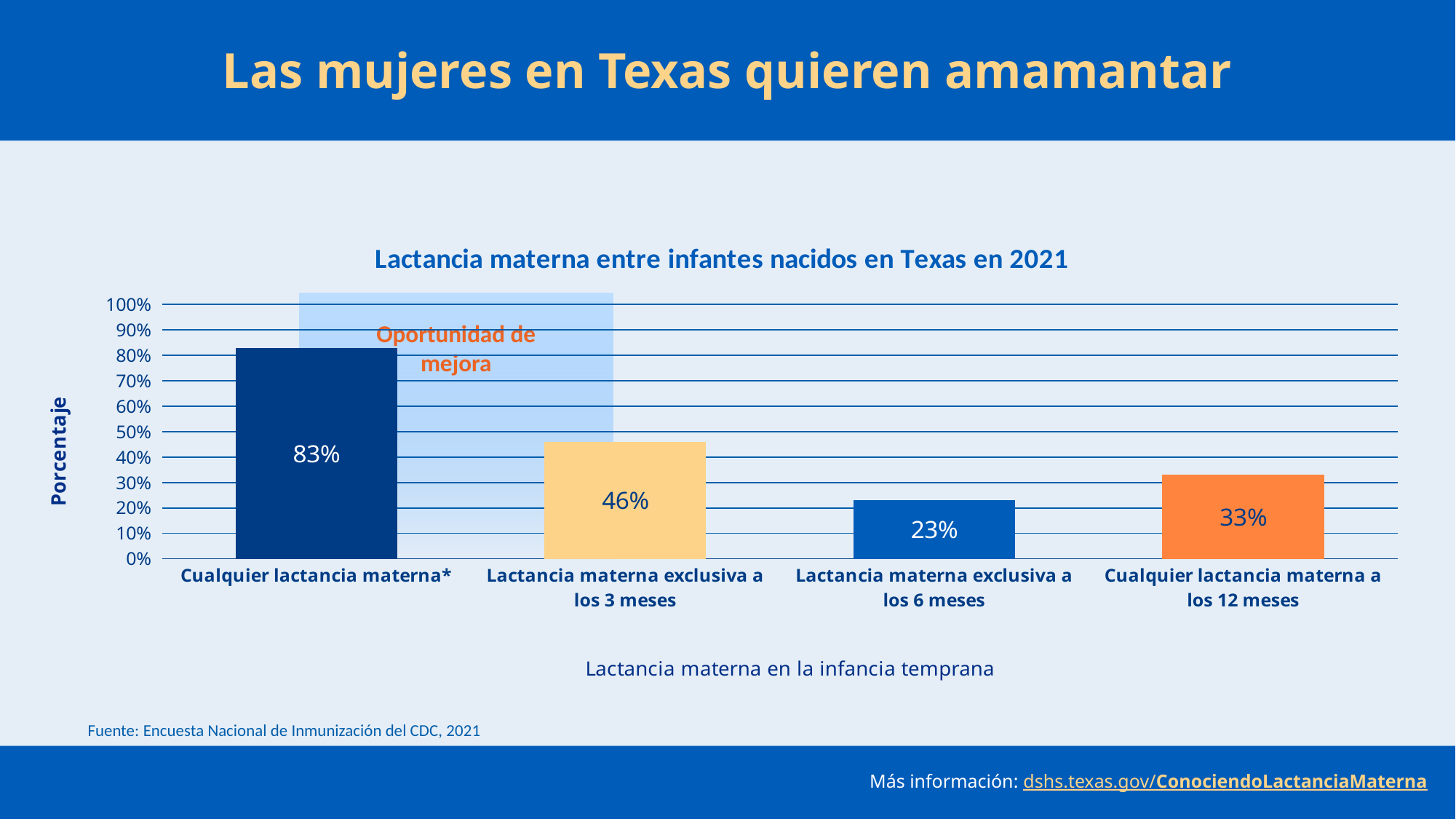
What kind of chart is shown on the slide? Bar chart Which is larger: "Lactancia materna exclusiva a los 3 meses" or "Cualquier lactancia materna a los 12 meses"? Lactancia materna exclusiva a los 3 meses What is the difference between "Cualquier lactancia materna a los 12 meses" and "Lactancia materna exclusiva a los 6 meses"? 10% What is the value for "Lactancia materna exclusiva a los 3 meses"? 46% What is the value for "Cualquier lactancia materna*"? 83% How many categories are shown in the chart? 4 What is the value for "Cualquier lactancia materna a los 12 meses"? 33% What is the title of the chart? Lactancia materna entre infantes nacidos en Texas en 2021 Which category has the lowest value? Lactancia materna exclusiva a los 6 meses What is the difference between "Cualquier lactancia materna*" and "Lactancia materna exclusiva a los 3 meses"? 37% What is the value for "Lactancia materna exclusiva a los 6 meses"? 23% Which category has the highest value? Cualquier lactancia materna*